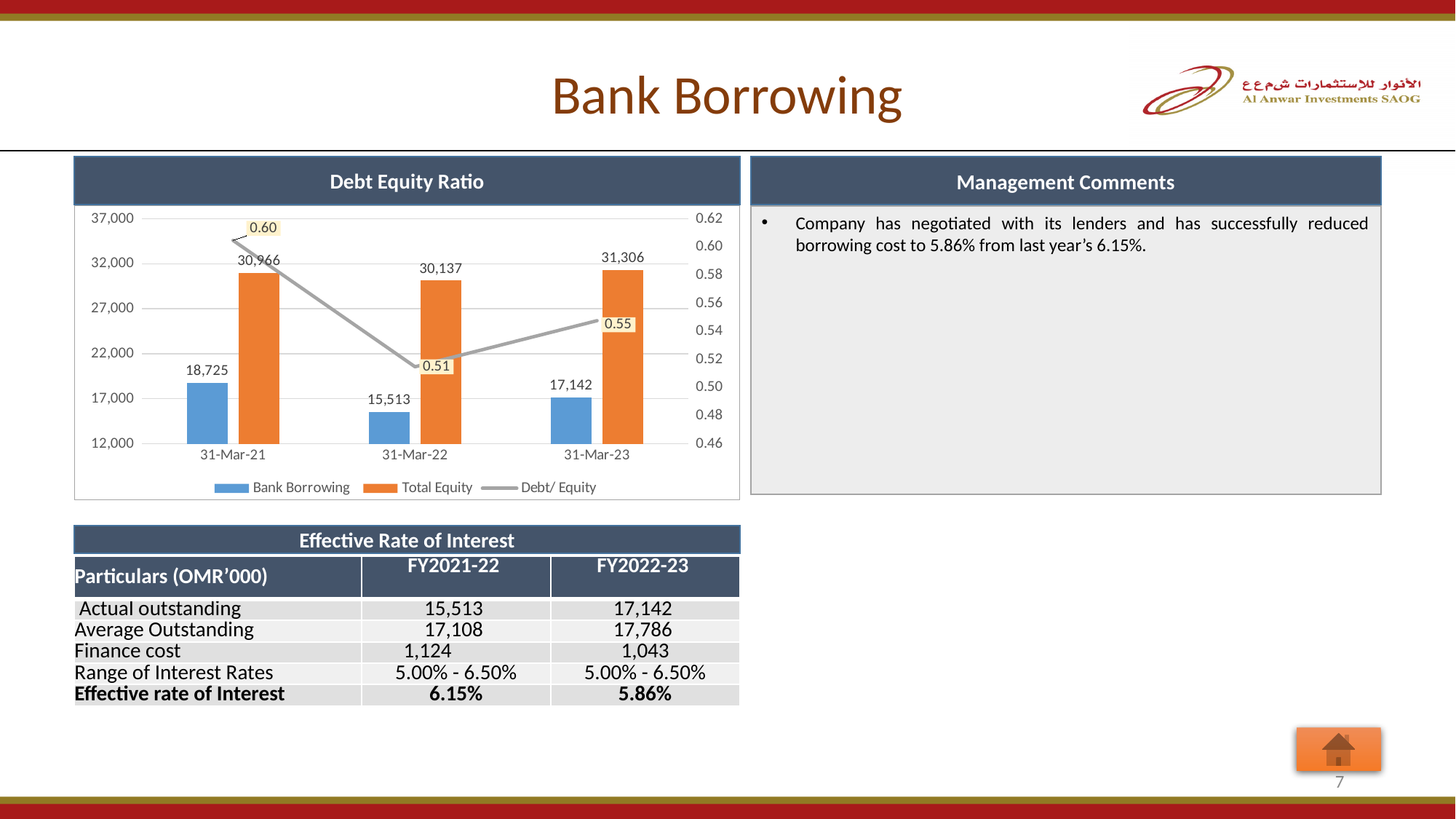
What is the Bank Borrowing value for 31-Mar-21 in the Debt Equity Ratio chart? 18,725 Which date has the highest Total Equity in the Debt Equity Ratio chart? 31-Mar-23 How many dates are shown on the x axis of the Debt Equity Ratio chart? 3 Is the Total Equity for 31-Mar-22 greater or less than 32,000 in the Debt Equity Ratio chart? less What kind of chart is the Debt Equity Ratio chart? Combined bar and line chart Which date has the lowest Bank Borrowing in the Debt Equity Ratio chart? 31-Mar-22 What is the difference between Total Equity and Bank Borrowing at 31-Mar-23 in the Debt Equity Ratio chart? 14,164 How many series does the legend of the Debt Equity Ratio chart list? 3 Does the Debt/ Equity ratio rise or fall from 31-Mar-21 to 31-Mar-22 in the Debt Equity Ratio chart? fall What is the Total Equity value for 31-Mar-22 in the Debt Equity Ratio chart? 30,137 What is the Debt/ Equity ratio for 31-Mar-23 in the Debt Equity Ratio chart? 0.55 Is the Bank Borrowing for 31-Mar-21 larger or smaller than the Bank Borrowing for 31-Mar-23 in the Debt Equity Ratio chart? larger